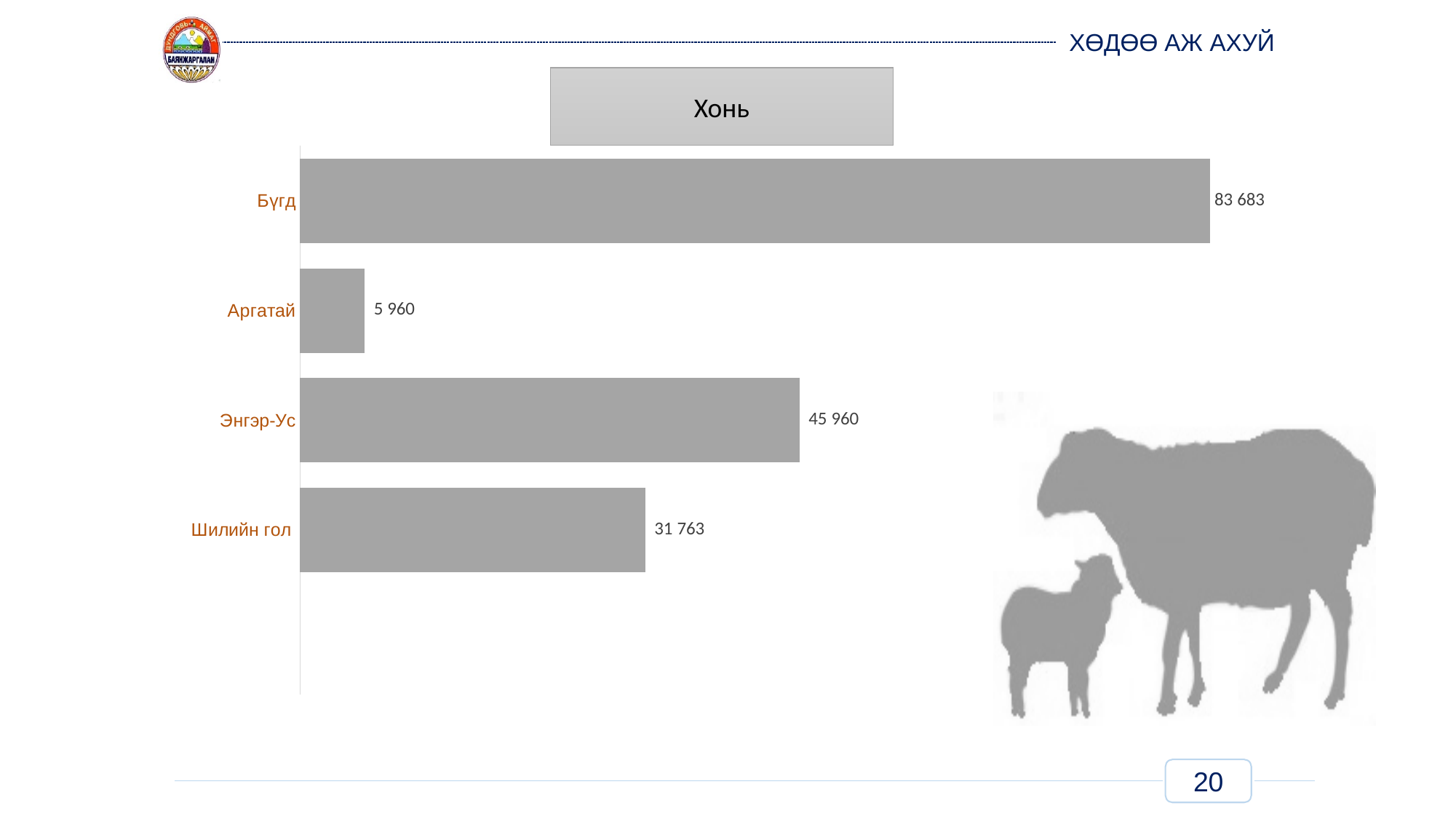
What is the value for Аргатай? 5 960 What is the value for Шилийн гол? 31 763 What is the difference between the values for Энгэр-Ус and Аргатай? 40 000 What kind of chart is shown on the slide? Bar chart How many categories are shown in the chart? 4 Which category has the highest value? Бүгд Which is larger, the value for Шилийн гол or the value for Аргатай? Шилийн гол What is the difference between the values for Энгэр-Ус and Шилийн гол? 14 197 What is the value for Энгэр-Ус? 45 960 What is the value for Бүгд? 83 683 What is the title of the chart? Хонь Which category has the lowest value? Аргатай